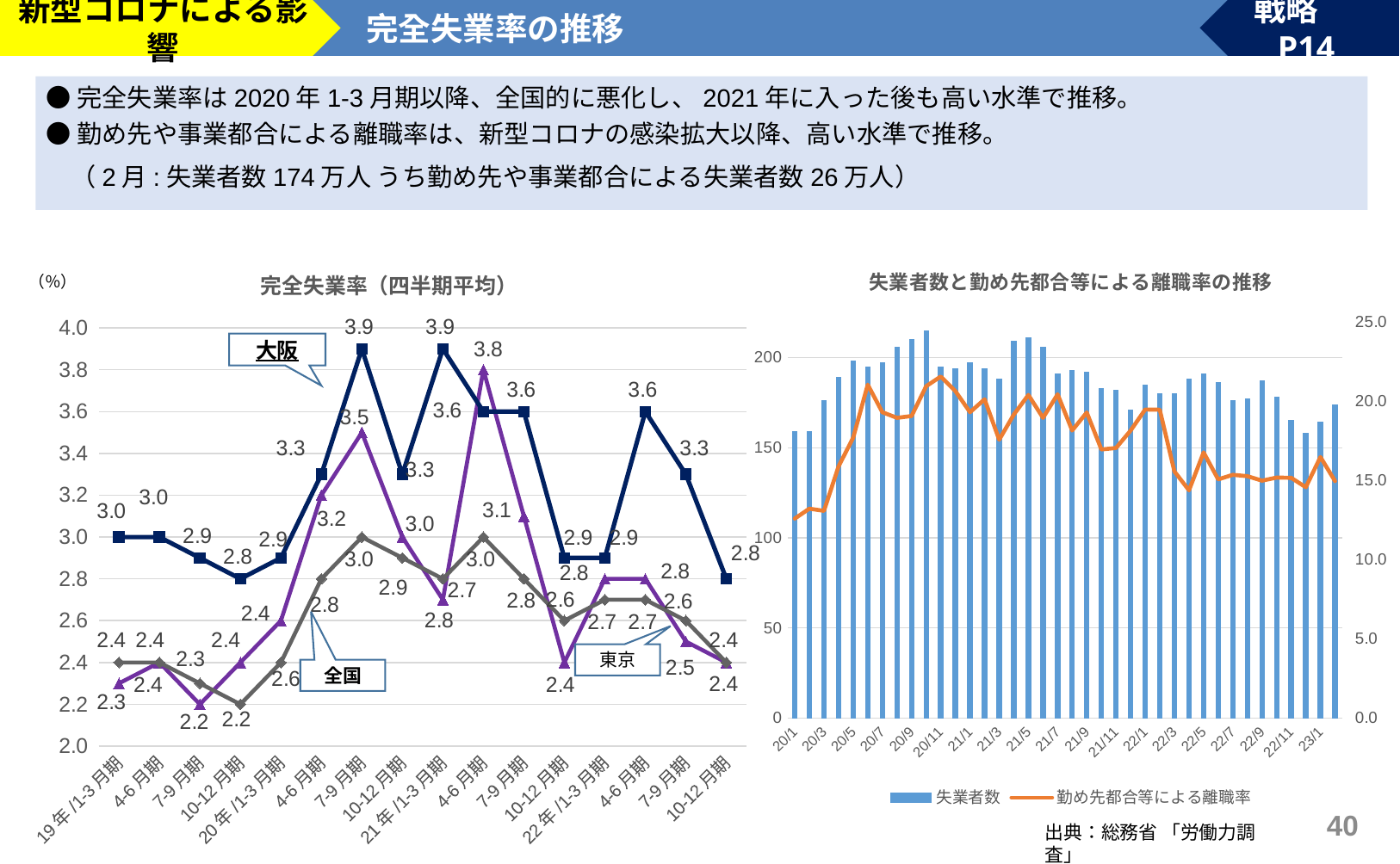
In the 失業者数と勤め先都合等による離職率の推移 chart, is the 勤め先都合等による離職率 value for 20/1 greater or less than 15.0? less What type of chart is the 完全失業率（四半期平均） chart on the left? line chart In the 完全失業率（四半期平均） chart, which is larger in 22年/4-6月期, 大阪 or 東京? 大阪 In the 完全失業率（四半期平均） chart, what is the difference between 大阪 and 全国 in 20年/7-9月期? 0.9 How many series does the legend of the 失業者数と勤め先都合等による離職率の推移 chart list? 2 How many series are plotted in the 完全失業率（四半期平均） chart? 3 How many quarterly periods are shown on the x axis of the 完全失業率（四半期平均） chart? 16 In the 完全失業率（四半期平均） chart, which series has the highest value in 21年/4-6月期? 東京 In the 完全失業率（四半期平均） chart, what is the value for 大阪 in 20年/7-9月期? 3.9 In the 失業者数と勤め先都合等による離職率の推移 chart, is the 失業者数 bar for 20/1 greater or less than 200? less In the 完全失業率（四半期平均） chart, what is the value for 全国 in 19年/10-12月期? 2.2 In the 完全失業率（四半期平均） chart, what is the value for 東京 in 21年/4-6月期? 3.8